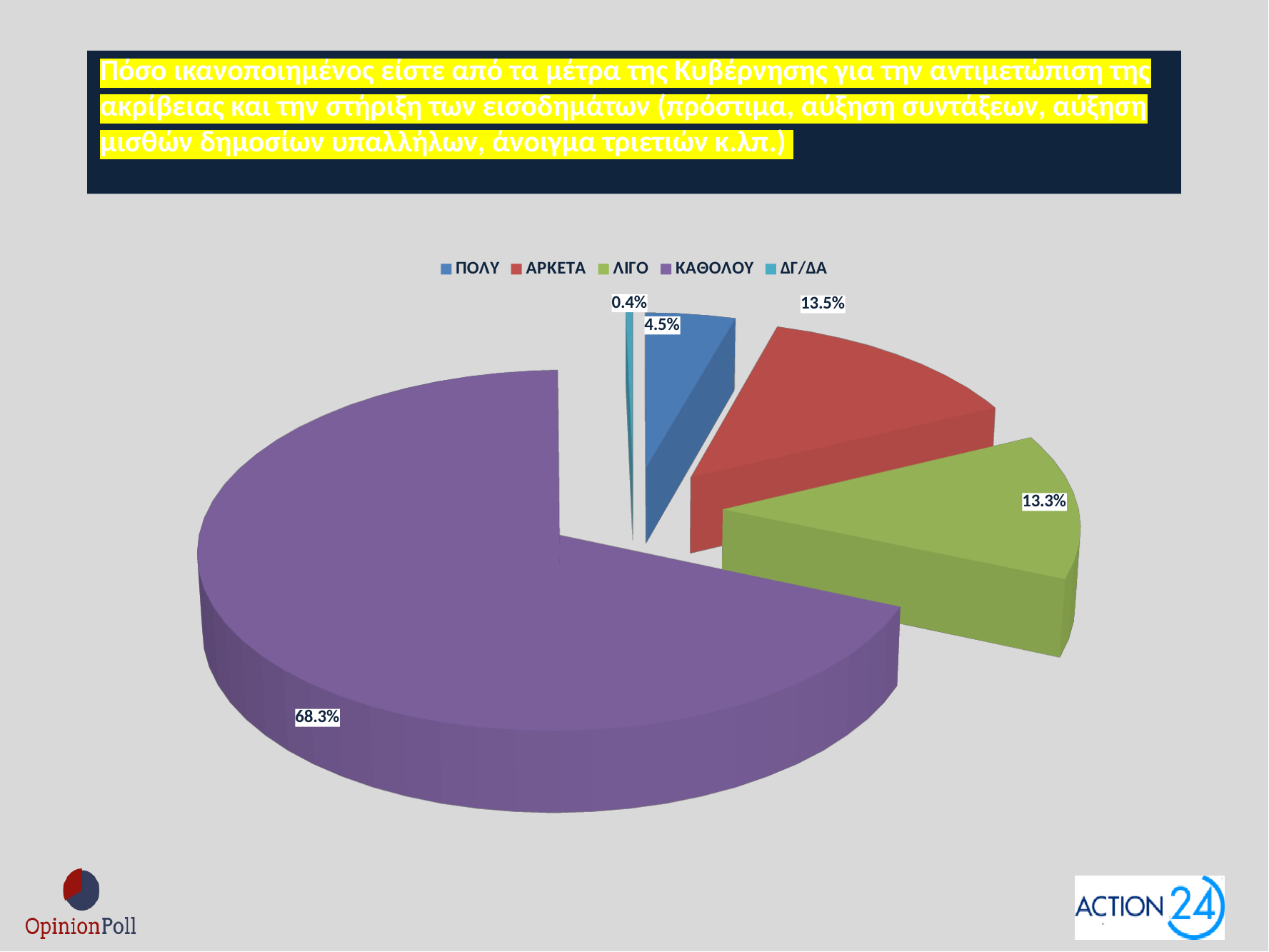
What percentage is shown for ΚΑΘΟΛΟΥ? 68.3% What kind of chart is shown on the slide? pie chart Which is larger, the share for ΚΑΘΟΛΟΥ or the share for ΠΟΛΥ? ΚΑΘΟΛΟΥ What percentage is shown for ΔΓ/ΔΑ? 0.4% What percentage is shown for ΛΙΓΟ? 13.3% What colour is the slice for ΚΑΘΟΛΟΥ? purple What is the difference in percentage points between ΑΡΚΕΤΑ and ΛΙΓΟ? 0.2 Which category has the largest slice of the pie? ΚΑΘΟΛΟΥ What percentage is shown for ΑΡΚΕΤΑ? 13.5% Which category has the smallest slice of the pie? ΔΓ/ΔΑ How many categories does the legend list? 5 What percentage is shown for ΠΟΛΥ? 4.5%